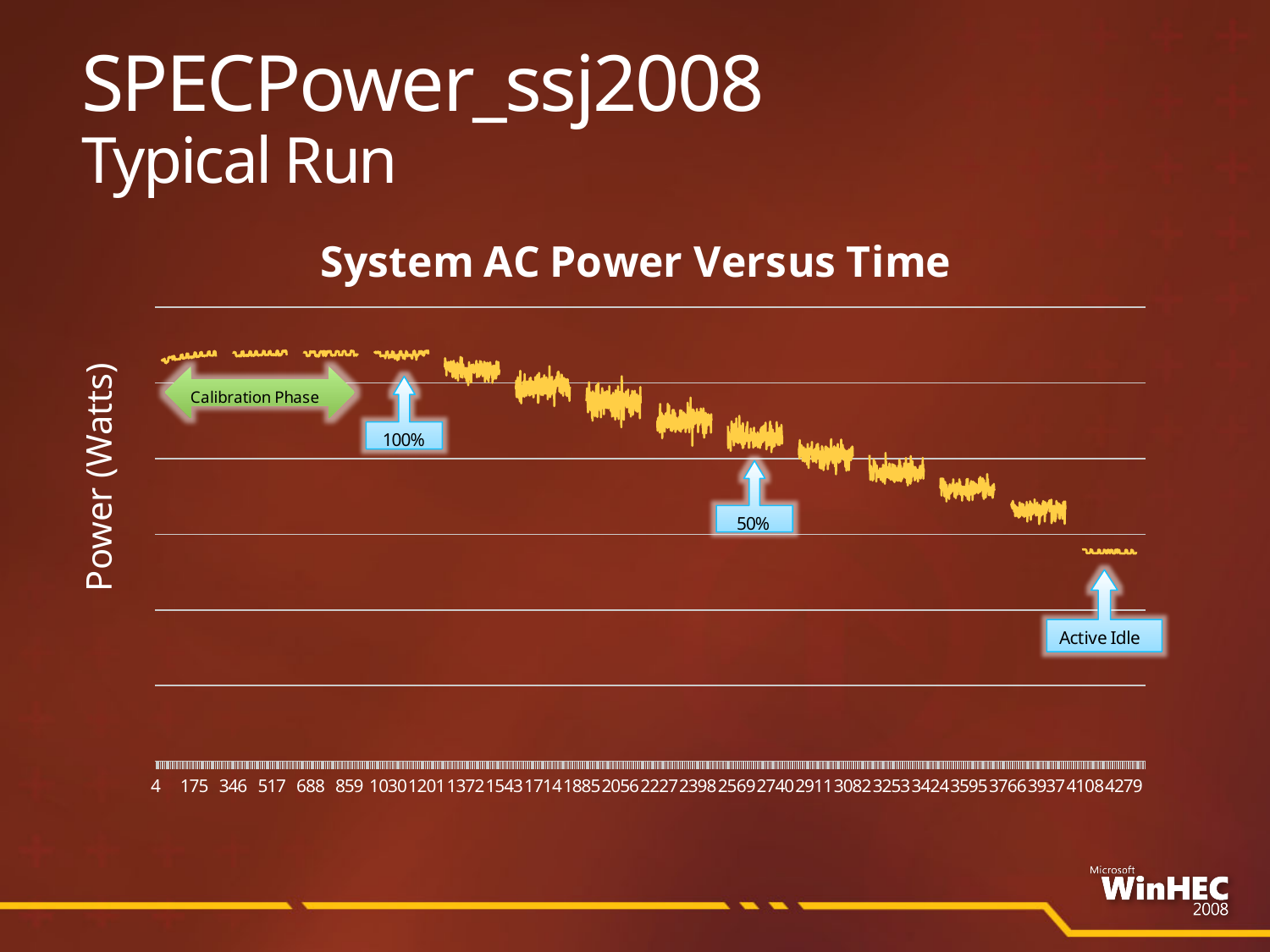
What is the title of the chart? System AC Power Versus Time What is the last tick label on the x axis? 4279 What is the label on the vertical axis of the chart? Power (Watts) What label is shown in the green arrow at the start of the run? Calibration Phase What is the first tick label on the x axis? 4 Is the power during the Calibration Phase higher or lower than the power during Active Idle? higher What kind of chart is shown on the slide? line chart Which annotated phase of the run shows the lowest power level? Active Idle Is the power at the 100% load level higher or lower than at the 50% load level? higher Does the plotted power rise or fall as time increases along the x axis? fall